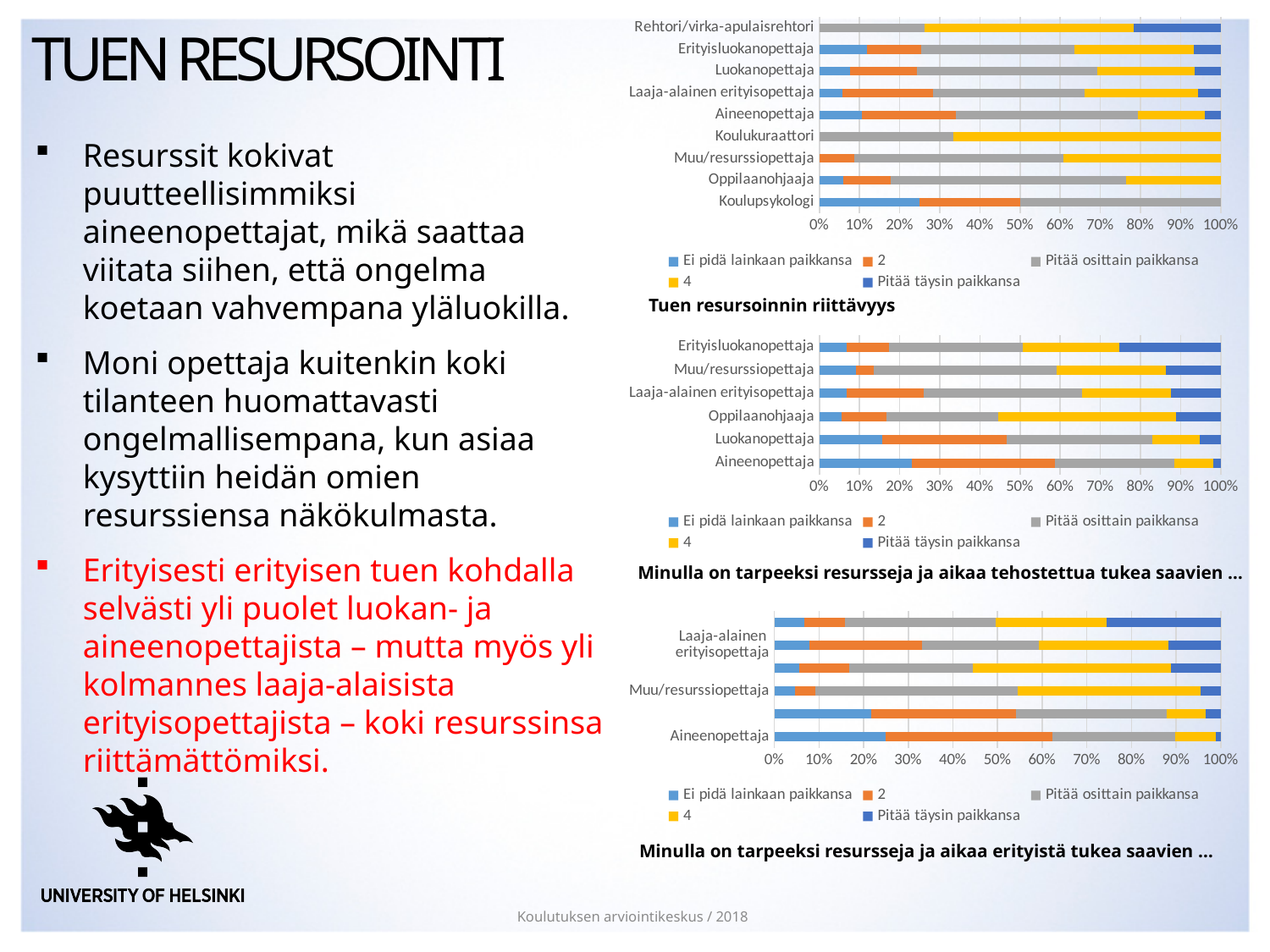
In the middle chart 'Minulla on tarpeeksi resursseja ja aikaa tehostettua tukea saavien ...', which category has the largest 'Ei pidä lainkaan paikkansa' share? Aineenopettaja How many series does the legend of the top chart list? 5 How many categories are shown in the top chart titled 'Tuen resursoinnin riittävyys'? 9 How many categories are shown in the middle chart titled 'Minulla on tarpeeksi resursseja ja aikaa tehostettua tukea saavien ...'? 6 In the top chart 'Tuen resursoinnin riittävyys', is the 'Pitää osittain paikkansa' segment for Rehtori/virka-apulaisrehtori ending greater or less than 70%? less In the top chart 'Tuen resursoinnin riittävyys', is the 'Pitää osittain paikkansa' segment for Koulukuraattori ending greater or less than 40%? less In the top chart 'Tuen resursoinnin riittävyys', is the 'Ei pidä lainkaan paikkansa' share for Koulupsykologi greater or less than 20%? greater Which legend entry is shown in grey in the charts? Pitää osittain paikkansa In the top chart 'Tuen resursoinnin riittävyys', which category has the largest 'Ei pidä lainkaan paikkansa' share? Koulupsykologi What kind of chart is the top chart titled 'Tuen resursoinnin riittävyys'? Stacked bar chart What is the title of the bottom chart on the slide? Minulla on tarpeeksi resursseja ja aikaa erityistä tukea saavien ...